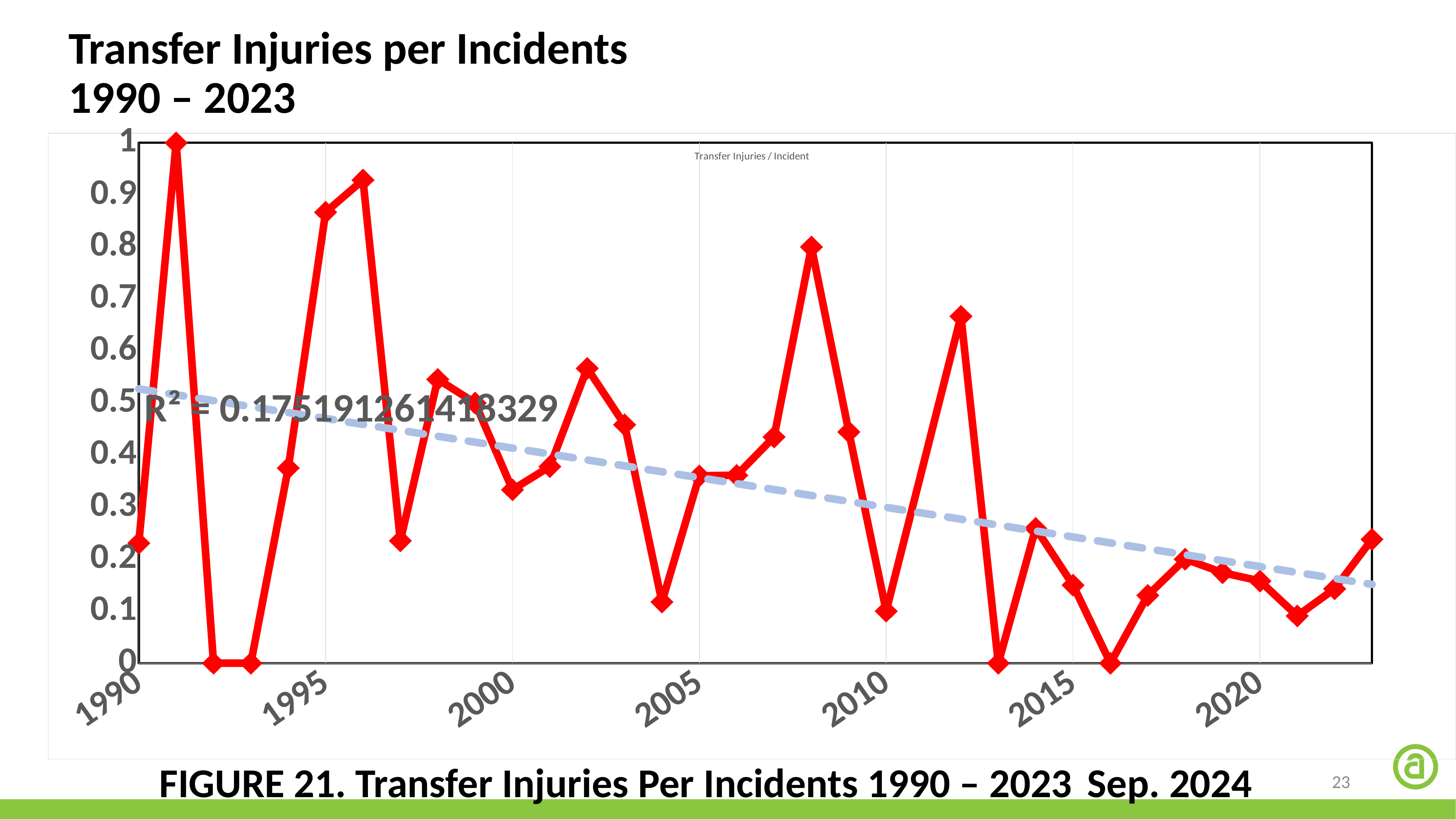
What is the highest value reached by the red line on the chart? 1 Which has the larger value, 1995 or 2000? 1995 Does the dashed trend line rise or fall from 1990 to 2023? fall Which has the larger value, 2005 or 2010? 2005 Is the value for 1990 greater or less than 0.3? less What is the lowest value reached by the red line on the chart? 0 Is the value for 1995 greater or less than 0.8? greater What is the title of the chart on the slide? Transfer Injuries per Incidents 1990 – 2023 How many year labels are shown on the x axis? 7 Is the value for 2010 greater or less than 0.2? less What kind of chart is shown on the slide? line chart What R² value is printed on the chart? R² = 0.175191261418329